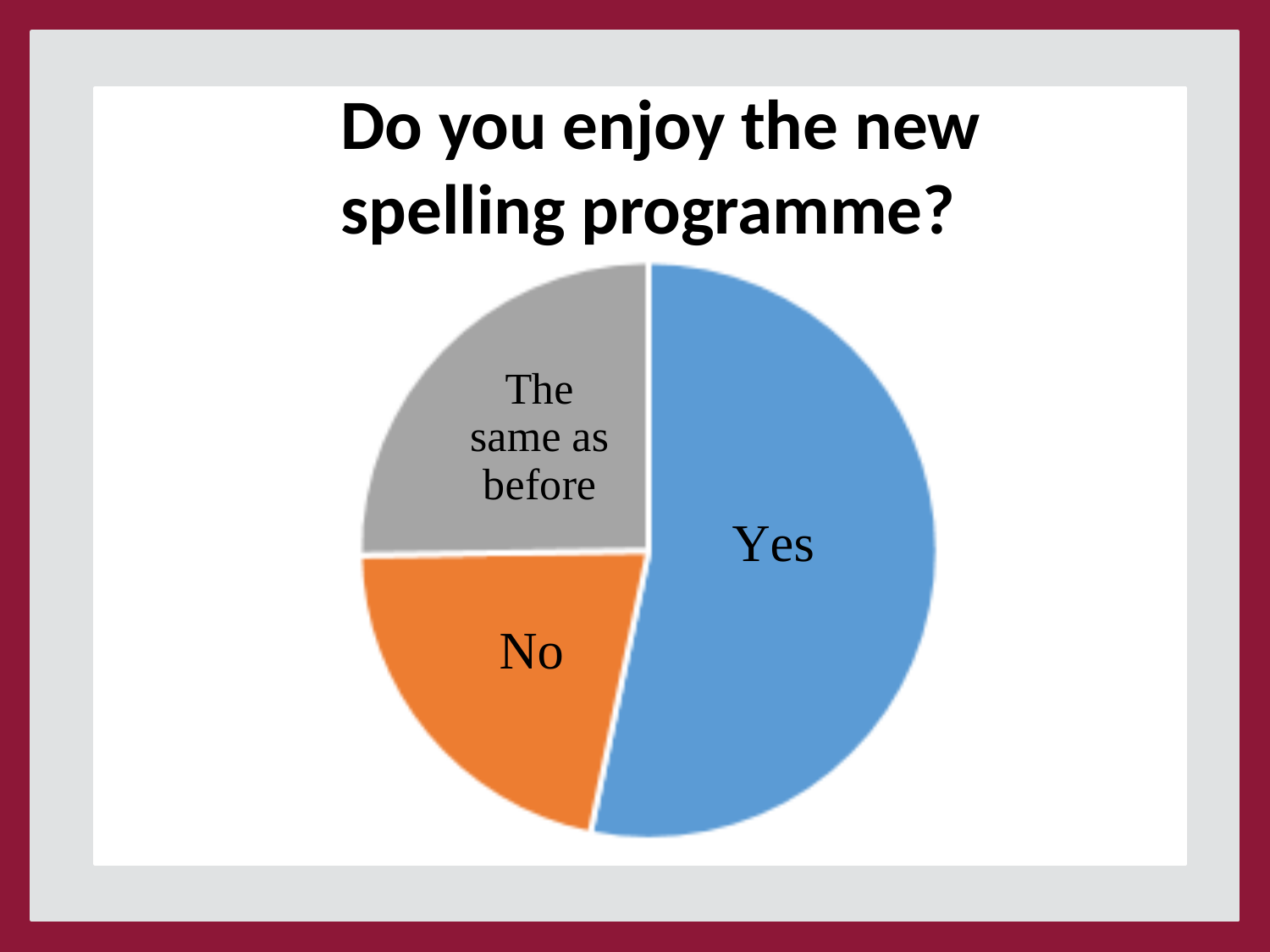
Which slice is larger, Yes or The same as before? Yes Which response has the largest slice of the pie chart? Yes How many slices does the pie chart have? 3 What kind of chart is shown on the slide? pie chart Which slice is larger, Yes or No? Yes What colour is the Yes slice of the pie chart? blue What is the title of the pie chart? Do you enjoy the new spelling programme?